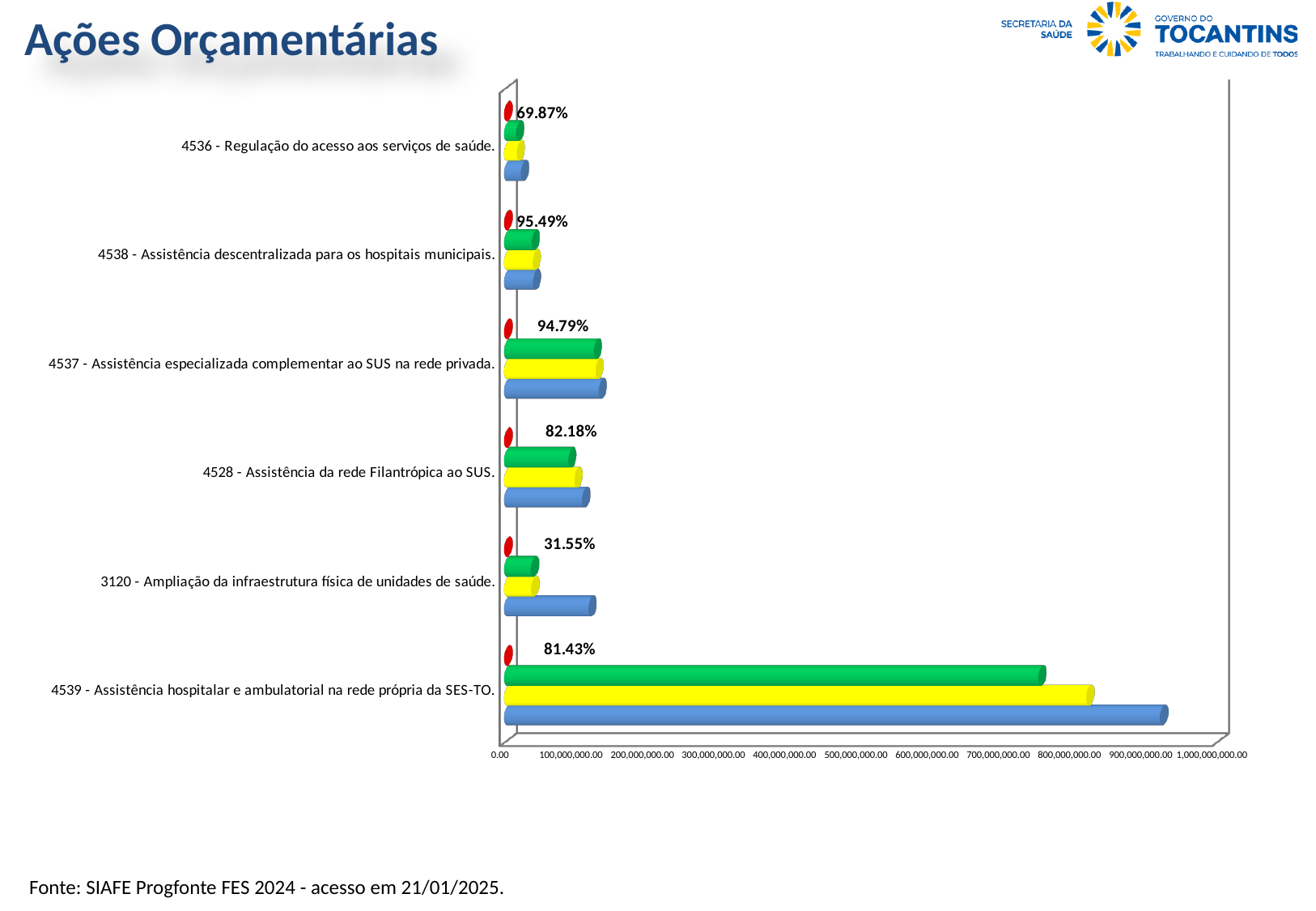
What type of chart is shown on the slide? Bar chart What is the difference between the percentage labels for 4538 and 4537? 0.70% What percentage is shown for 3120 - Ampliação da infraestrutura física de unidades de saúde? 31.55% How many budget actions (categories) are shown on the chart? 6 What percentage is shown for 4538 - Assistência descentralizada para os hospitais municipais? 95.49% Is the blue bar for 4539 - Assistência hospitalar e ambulatorial na rede própria da SES-TO greater or less than 800,000,000.00? greater Is the blue bar for 4536 - Regulação do acesso aos serviços de saúde greater or less than 100,000,000.00? less Which has the higher percentage label: 4528 - Assistência da rede Filantrópica ao SUS or 4539 - Assistência hospitalar e ambulatorial na rede própria da SES-TO? 4528 - Assistência da rede Filantrópica ao SUS. Which budget action has the highest percentage label? 4538 - Assistência descentralizada para os hospitais municipais. What percentage is shown for 4539 - Assistência hospitalar e ambulatorial na rede própria da SES-TO? 81.43% Which budget action has the lowest percentage label? 3120 - Ampliação da infraestrutura física de unidades de saúde. What percentage is shown for 4536 - Regulação do acesso aos serviços de saúde? 69.87%